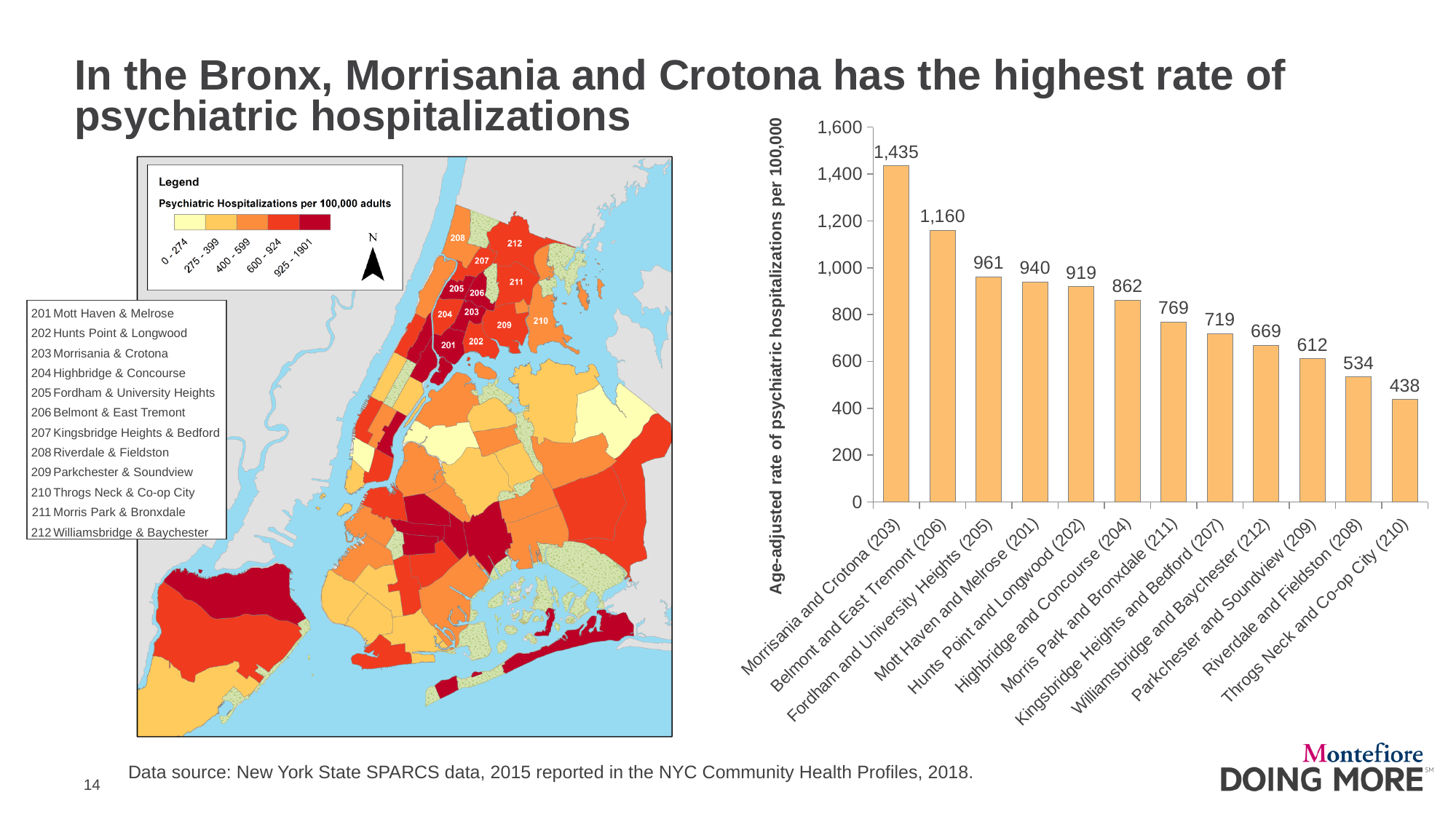
How many neighborhoods are plotted in the bar chart? 12 What is the age-adjusted rate of psychiatric hospitalizations per 100,000 for Morrisania and Crotona (203)? 1,435 What is the value shown for Hunts Point and Longwood (202)? 919 What is the value shown for Riverdale and Fieldston (208)? 534 What is the value shown for Belmont and East Tremont (206)? 1,160 What kind of chart is used to show the psychiatric hospitalization rates? Bar chart What is the label on the vertical axis of the bar chart? Age-adjusted rate of psychiatric hospitalizations per 100,000 Which neighborhood has the lowest rate of psychiatric hospitalizations in the bar chart? Throgs Neck and Co-op City (210) Which neighborhood has the highest rate of psychiatric hospitalizations in the bar chart? Morrisania and Crotona (203) Do the values in the bar chart rise or fall from left to right? Fall What is the difference between the values for Morrisania and Crotona (203) and Belmont and East Tremont (206)? 275 Which has a higher rate: Fordham and University Heights (205) or Mott Haven and Melrose (201)? Fordham and University Heights (205)